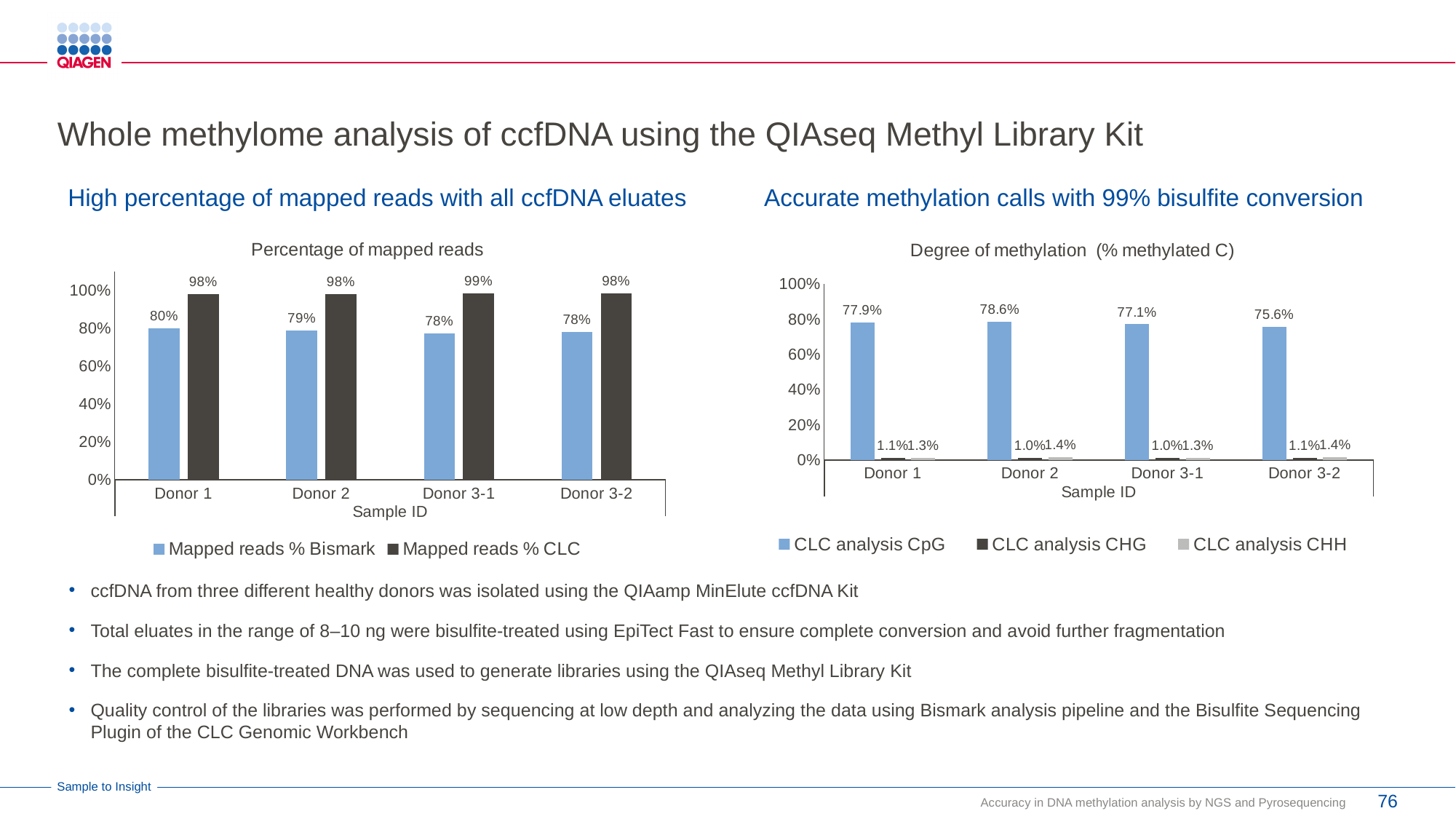
In the 'Degree of methylation (% methylated C)' chart, what is the difference between the CpG values for Donor 2 and Donor 3-2? 3.0% In the 'Degree of methylation (% methylated C)' chart, how many donor categories are shown on the x axis? 4 In the 'Percentage of mapped reads' chart, what is the difference between the CLC and Bismark mapped reads percentages for Donor 2? 19% In the 'Percentage of mapped reads' chart, how many series does the legend list? 2 In the 'Percentage of mapped reads' chart, what is the Mapped reads % CLC value for Donor 3-1? 99% In the 'Percentage of mapped reads' chart, what kind of chart is shown? Bar chart In the 'Percentage of mapped reads' chart, which donor has the highest Mapped reads % Bismark value? Donor 1 In the 'Degree of methylation (% methylated C)' chart, which donor has the lowest CLC analysis CpG value? Donor 3-2 In the 'Percentage of mapped reads' chart, what is the Mapped reads % Bismark value for Donor 1? 80% In the 'Degree of methylation (% methylated C)' chart, which series is shown in light blue? CLC analysis CpG In the 'Degree of methylation (% methylated C)' chart, what is the CLC analysis CpG value for Donor 2? 78.6% In the 'Degree of methylation (% methylated C)' chart, what is the CLC analysis CHH value for Donor 3-2? 1.4%